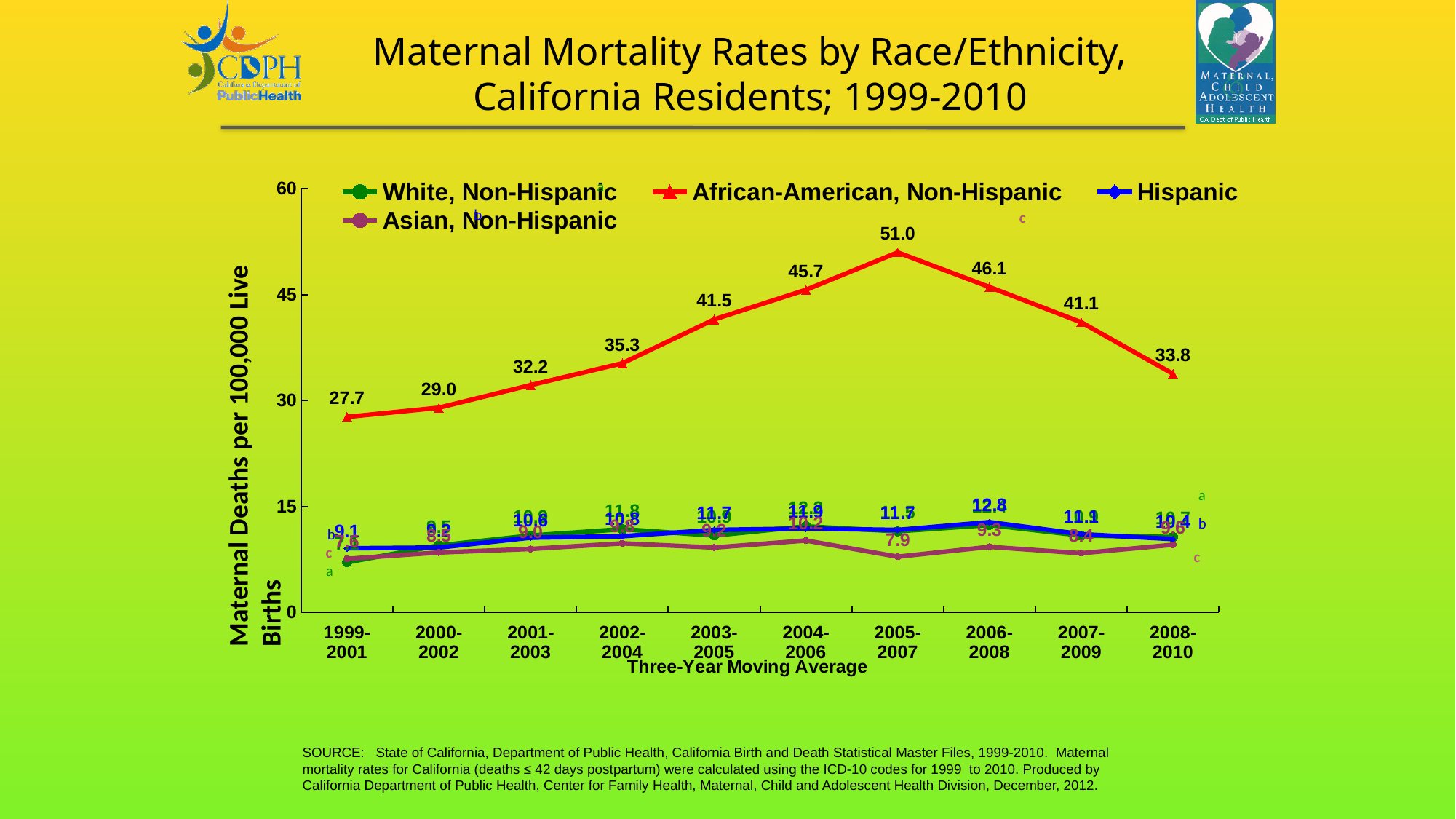
What is the difference between the African-American, Non-Hispanic rate in 2005-2007 and in 1999-2001? 23.3 Is the Hispanic rate in 2005-2007 greater or less than 30? less In which period is the African-American, Non-Hispanic rate lowest? 1999-2001 For African-American, Non-Hispanic, which period has the higher rate: 2004-2006 or 2006-2008? 2006-2008 In which period is the African-American, Non-Hispanic rate highest? 2005-2007 What kind of chart is shown on the slide? line chart Does the African-American, Non-Hispanic rate rise or fall from 2005-2007 to 2008-2010? fall How many three-year periods are shown along the x axis? 10 What is the maternal mortality rate for African-American, Non-Hispanic in 2008-2010? 33.8 How many series does the legend list? 4 What is the maternal mortality rate for African-American, Non-Hispanic in 2005-2007? 51.0 What is the maternal mortality rate for African-American, Non-Hispanic in 1999-2001? 27.7